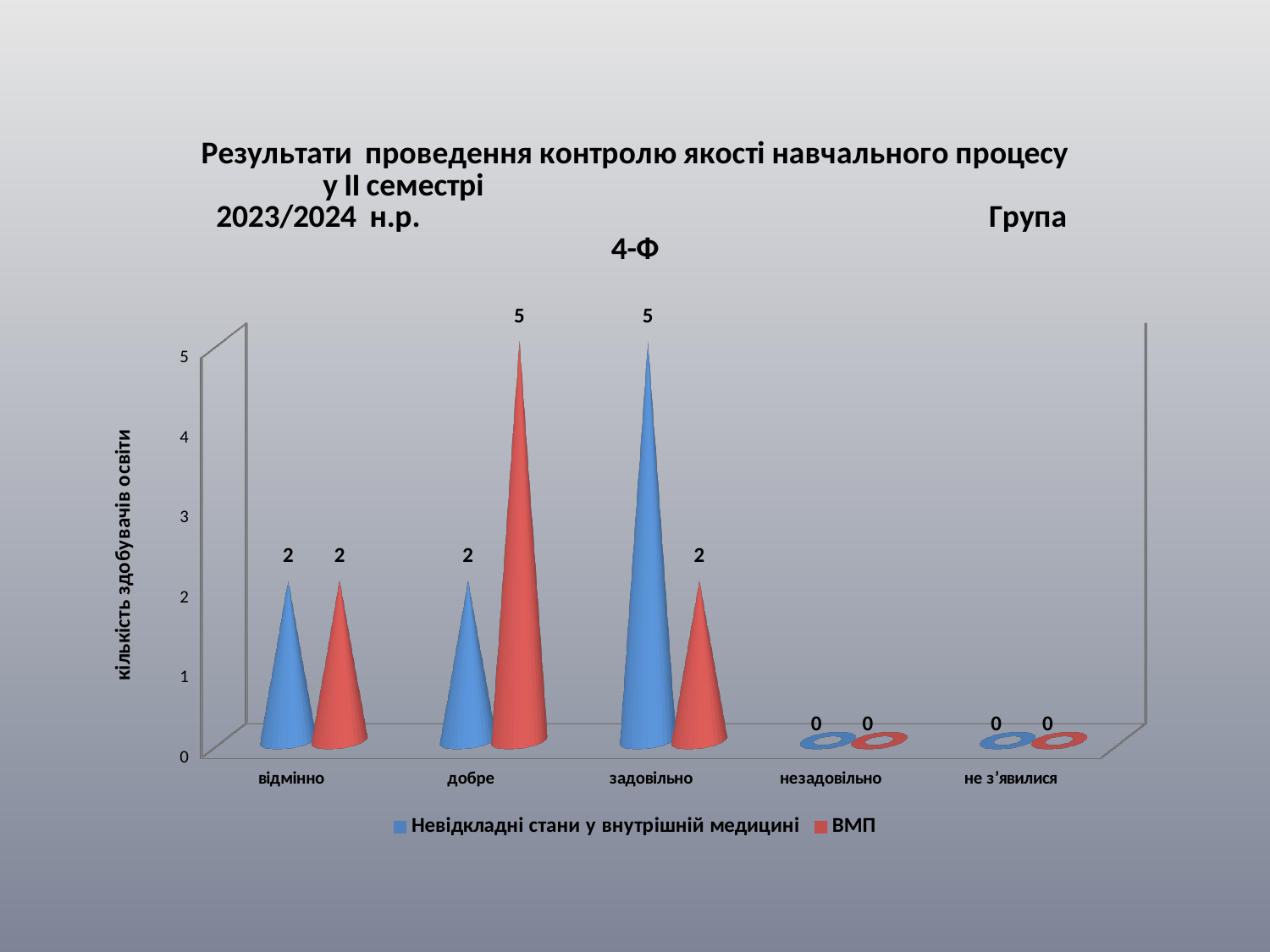
How many categories are shown on the x axis? 5 What is the value for "незадовільно" in the "ВМП" series? 0 What kind of chart is shown on the slide? bar chart Which category has the highest value in the "Невідкладні стани у внутрішній медицині" series? задовільно How many series does the legend list? 2 For "задовільно", which series has the larger value? Невідкладні стани у внутрішній медицині What is the value for "добре" in the "ВМП" series? 5 Which category has the highest value in the "ВМП" series? добре What is the value for "відмінно" in the "ВМП" series? 2 What is the difference between the "ВМП" and "Невідкладні стани у внутрішній медицині" values for "добре"? 3 What is the value for "задовільно" in the "Невідкладні стани у внутрішній медицині" series? 5 What is the label of the vertical axis? кількість здобувачів освіти